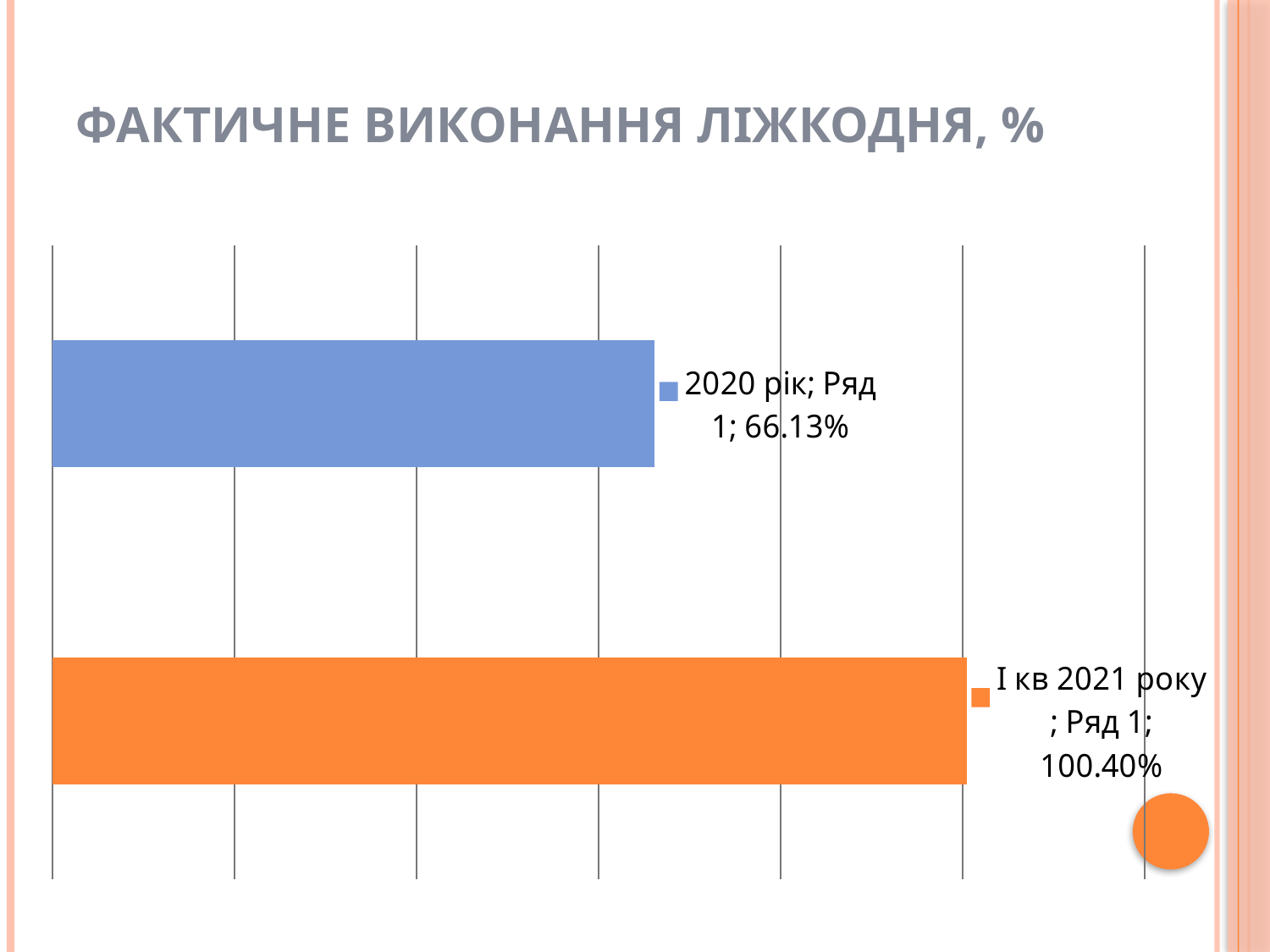
Is the value for І кв 2021 року greater or less than 100%? greater What is the title of the slide? ФАКТИЧНЕ ВИКОНАННЯ ЛІЖКОДНЯ, % What is the value for І кв 2021 року? 100.40% What kind of chart is shown on the slide? Bar chart What is the difference between the values for І кв 2021 року and 2020 рік? 34.27 percentage points Which category has the highest value? І кв 2021 року Which category has the lowest value? 2020 рік What colour is the bar for І кв 2021 року? Orange What is the value for 2020 рік? 66.13% How many categories are plotted in the chart? 2 Which is larger, the value for 2020 рік or the value for І кв 2021 року? І кв 2021 року